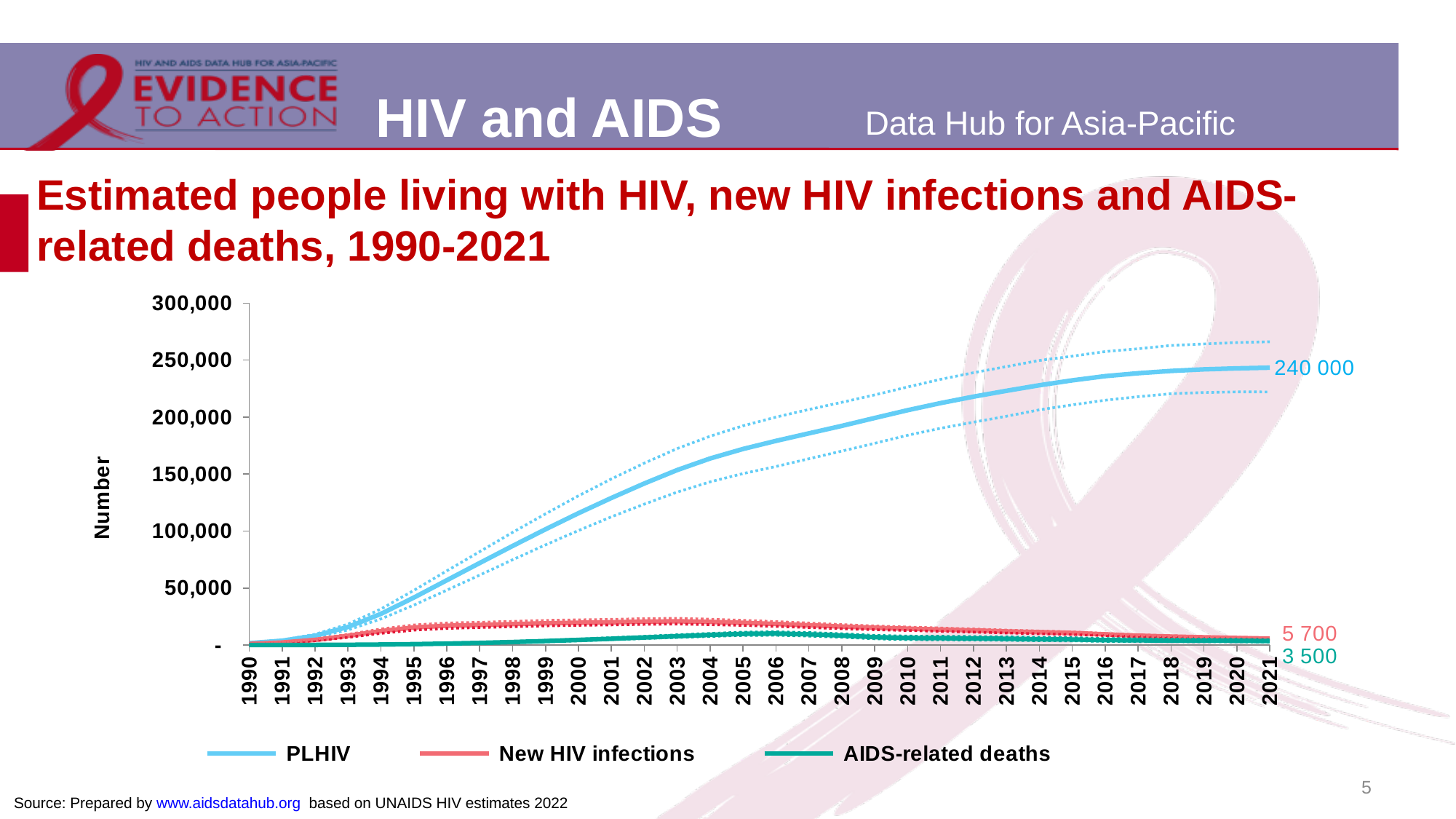
In 2021, which is larger: New HIV infections or AIDS-related deaths? New HIV infections How many series does the legend list? 3 What is the labelled value for PLHIV in 2021? 240 000 Is the PLHIV value for 2000 greater or less than 150,000? less What kind of chart is shown on the slide? Line chart Which series has the lowest value in 2021? AIDS-related deaths What is the labelled value for New HIV infections in 2021? 5 700 Does the PLHIV line rise or fall from 1990 to 2021? Rises Is the PLHIV value for 2010 greater or less than 150,000? greater What is the difference between the 2021 values for New HIV infections and AIDS-related deaths? 2 200 Which series has the highest value in 2021? PLHIV What is the labelled value for AIDS-related deaths in 2021? 3 500